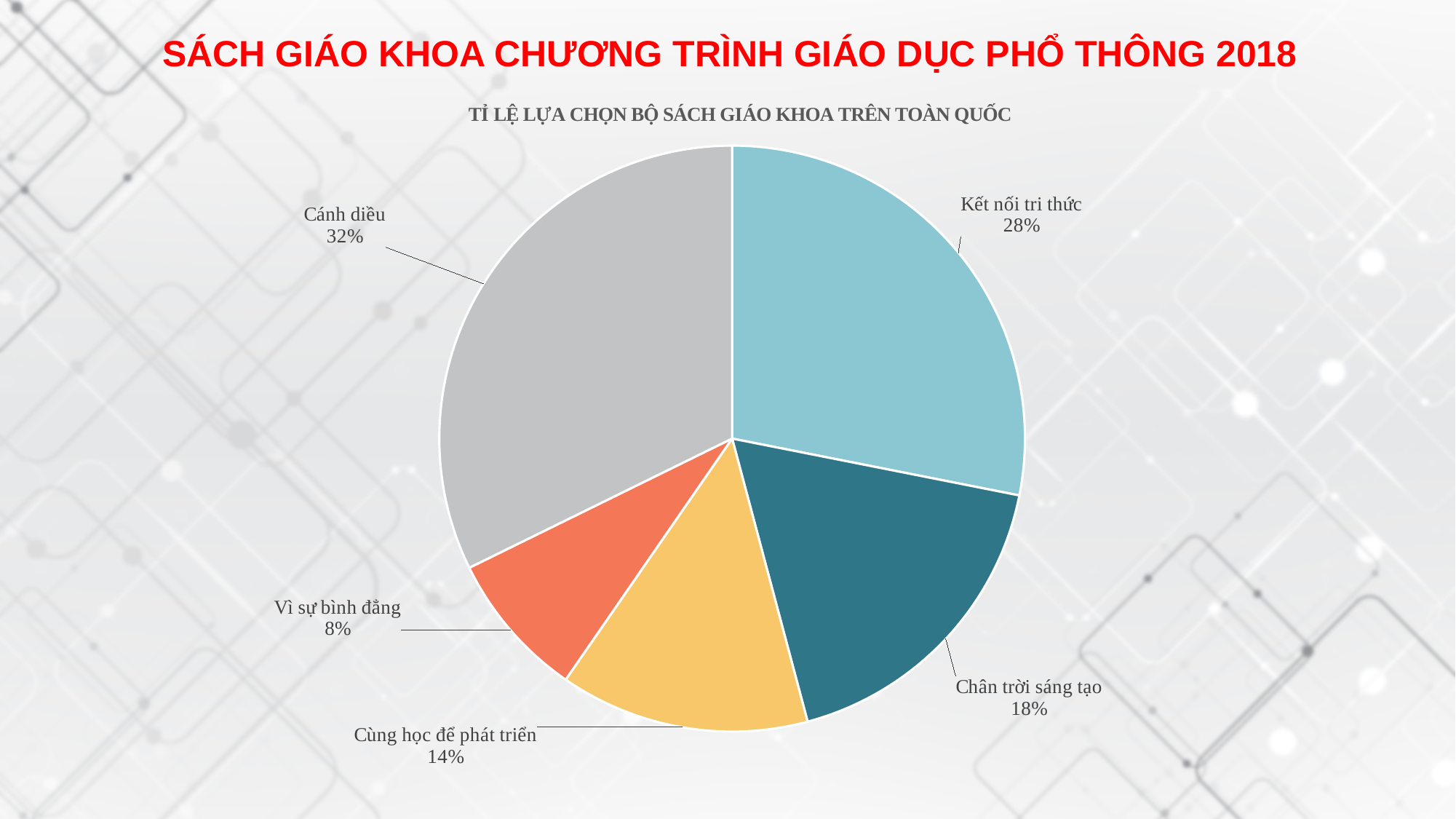
How many slices does the pie chart have? 5 Which textbook set has the smallest share? Vì sự bình đẳng What is the difference in percentage points between Cánh diều and Kết nối tri thức? 4 What percentage is shown for Cánh diều? 32% Which has a larger share, Chân trời sáng tạo or Cùng học để phát triển? Chân trời sáng tạo What is the chart's title? TỈ LỆ LỰA CHỌN BỘ SÁCH GIÁO KHOA TRÊN TOÀN QUỐC What percentage is shown for Cùng học để phát triển? 14% What type of chart is shown on the slide? pie chart Which textbook set has the largest share? Cánh diều What percentage is shown for Kết nối tri thức? 28% What percentage is shown for Vì sự bình đẳng? 8% What percentage is shown for Chân trời sáng tạo? 18%